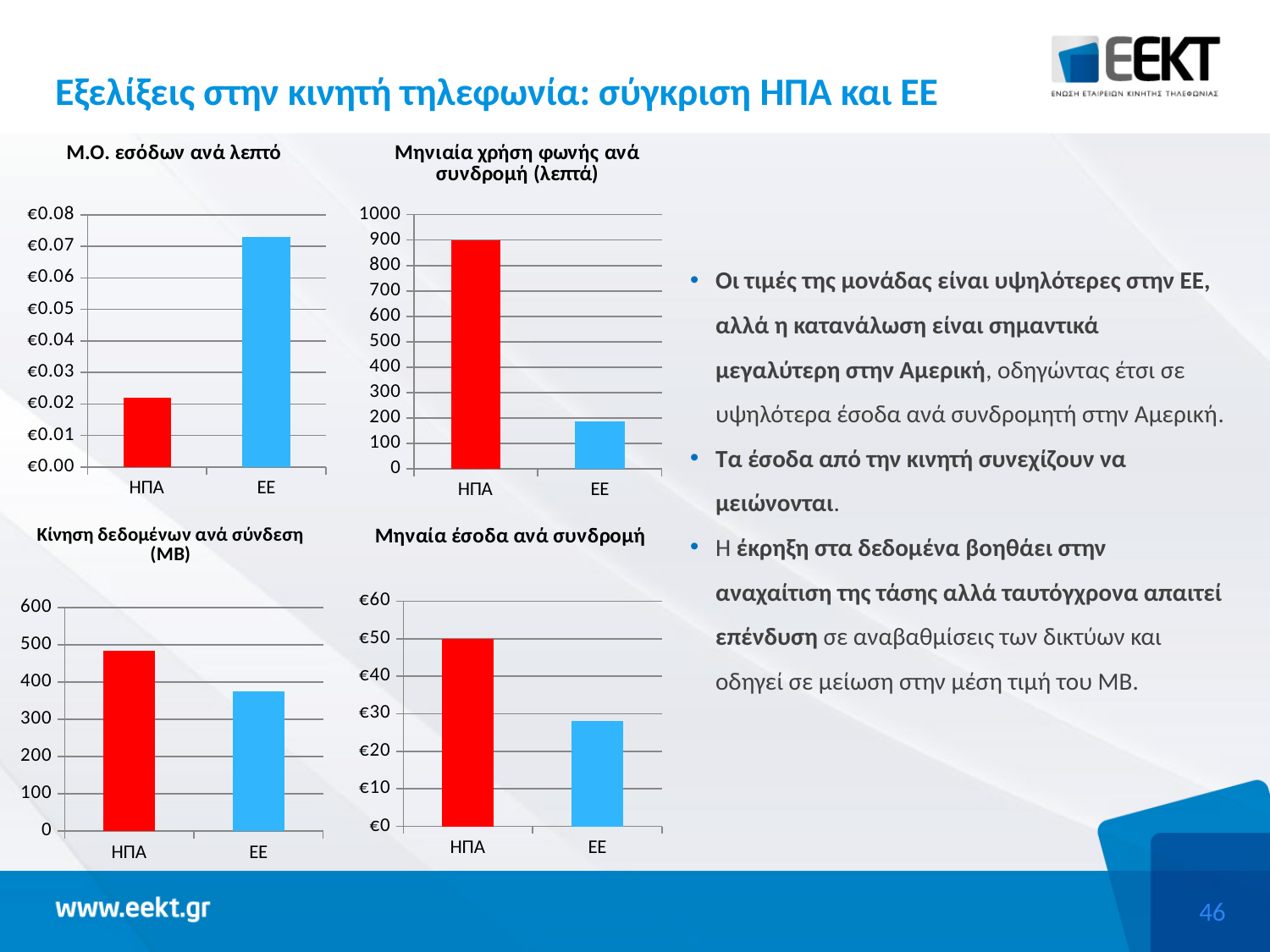
In the chart titled 'Μηναία έσοδα ανά συνδρομή', is the value for ΕΕ greater or less than €30? less In the chart titled 'Μηνιαία χρήση φωνής ανά συνδρομή (λεπτά)', is the value for ΕΕ greater or less than 300? less In the chart titled 'Μηναία έσοδα ανά συνδρομή', what is the value for ΗΠΑ? €50 In the chart titled 'Μ.Ο. εσόδων ανά λεπτό', is the value for ΕΕ greater or less than €0.07? greater In the chart titled 'Μ.Ο. εσόδων ανά λεπτό', which category has the higher value? ΕΕ In the chart titled 'Κίνηση δεδομένων ανά σύνδεση (MB)', which category has the higher value? ΗΠΑ How many categories are shown in the chart titled 'Μηναία έσοδα ανά συνδρομή'? 2 In the chart titled 'Μηνιαία χρήση φωνής ανά συνδρομή (λεπτά)', which category has the lower value? ΕΕ In the chart titled 'Μηνιαία χρήση φωνής ανά συνδρομή (λεπτά)', what is the value for ΗΠΑ? 900 What type of chart is the chart titled 'Κίνηση δεδομένων ανά σύνδεση (MB)'? bar chart